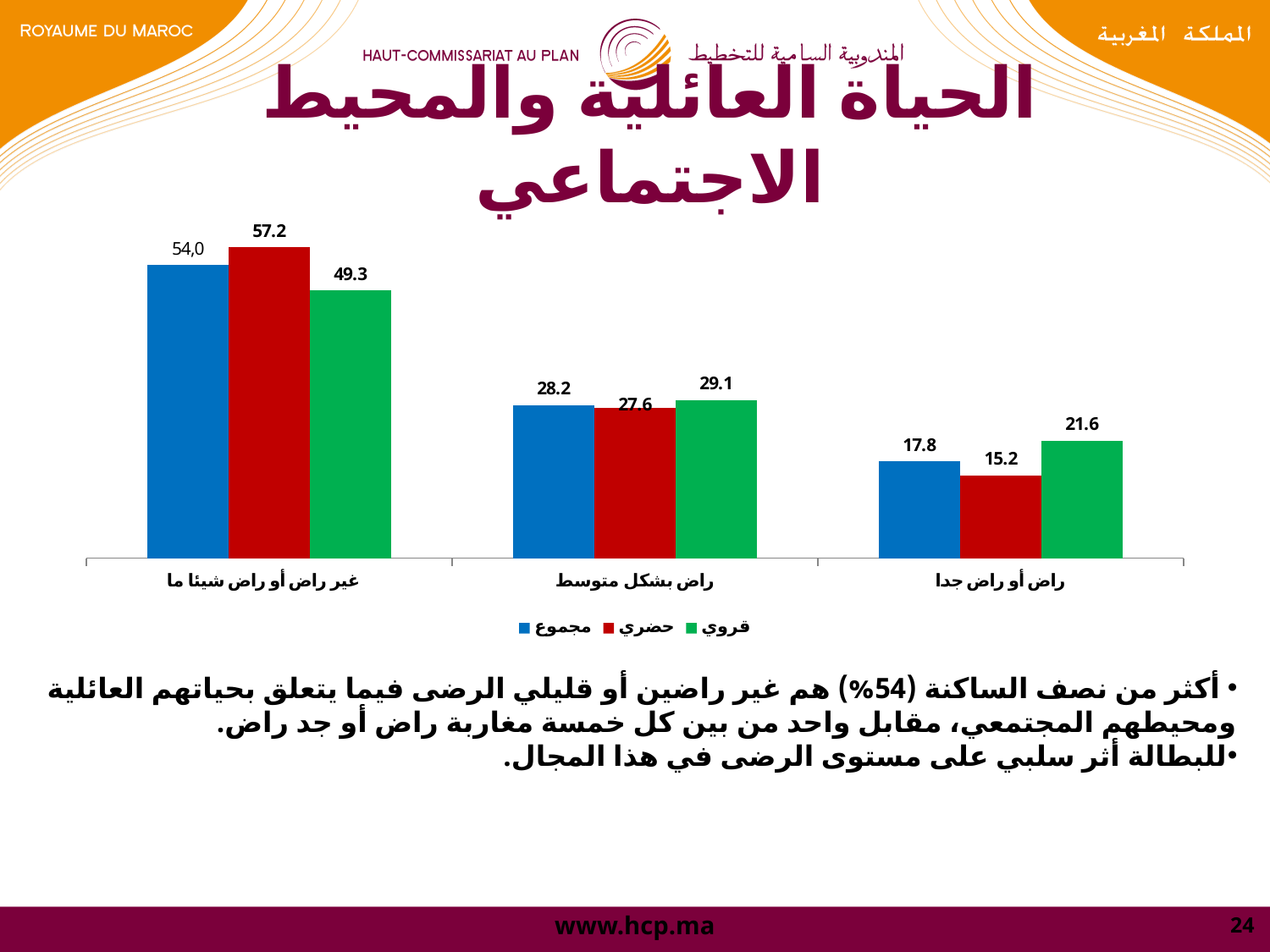
Which category has the lowest value for the قروي series? راض أو راض جدا Which colour represents the حضري series in the chart? red How many categories are shown on the x axis? 3 What is the value for مجموع in the category راض بشكل متوسط? 28.2 How many series does the legend list? 3 Which category has the highest value for the حضري series? غير راض أو راض شيئا ما In the category راض أو راض جدا, which is larger: the value for حضري or the value for قروي? قروي What is the value for حضري in the category غير راض أو راض شيئا ما? 57.2 What is the value for قروي in the category راض أو راض جدا? 21.6 What is the difference between the حضري and قروي values in the category غير راض أو راض شيئا ما? 7.9 What type of chart is shown on the slide? bar chart What is the value for مجموع in the category غير راض أو راض شيئا ما? 54,0